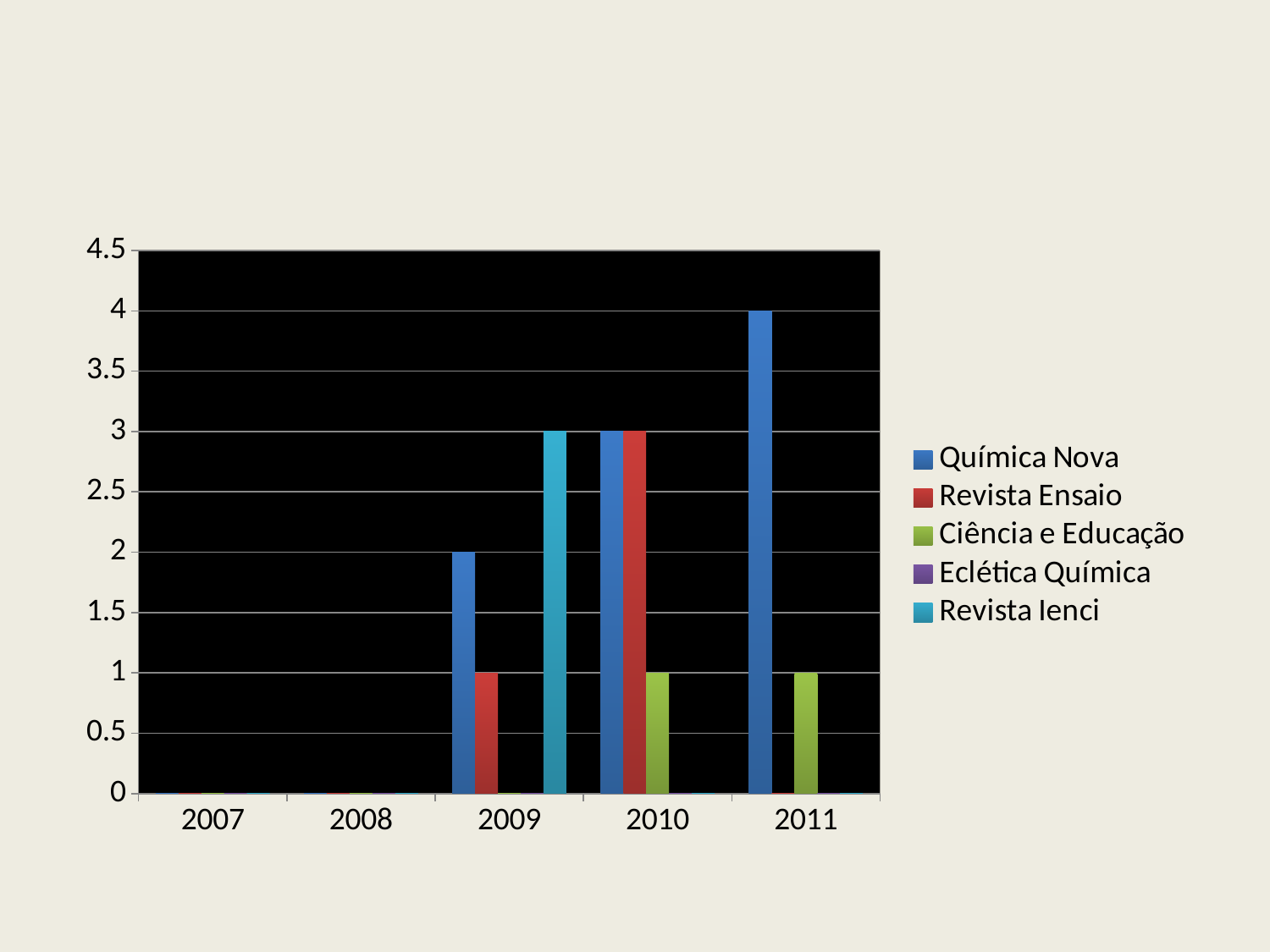
How many years are shown on the x axis? 5 What is the value for Química Nova in 2011? 4 Which is larger in 2009, Química Nova or Revista Ensaio? Química Nova In which year does Química Nova reach its highest value? 2011 What kind of chart is shown on the slide? bar chart Does the value for Química Nova rise or fall from 2009 to 2011? rise What is the value for Revista Ienci in 2009? 3 What is the value for Ciência e Educação in 2011? 1 Which legend entry is shown in green? Ciência e Educação What is the difference between Química Nova in 2011 and Química Nova in 2009? 2 What is the value for Revista Ensaio in 2010? 3 How many series does the legend list? 5